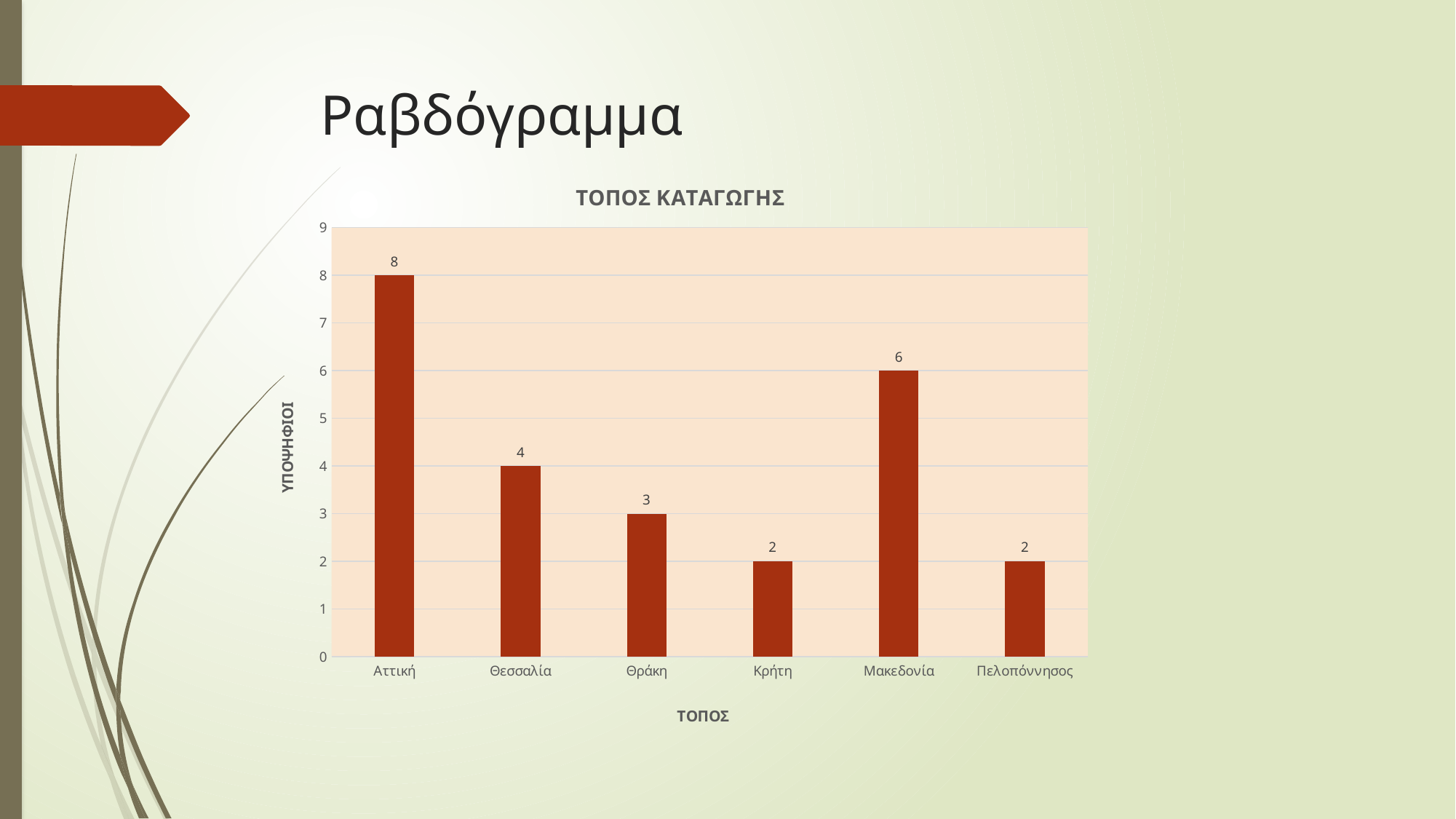
How many categories are shown on the x axis? 6 What is the value for Θράκη? 3 Which is larger, the value for Θεσσαλία or the value for Μακεδονία? Μακεδονία What kind of chart is shown on the slide? bar chart What is the difference between the values for Μακεδονία and Κρήτη? 4 What is the label of the vertical axis? ΥΠΟΨΗΦΙΟΙ Which category has the highest value? Αττική Is the value for Αττική greater or less than 5? greater What is the value for Αττική? 8 What is the difference between the values for Αττική and Θεσσαλία? 4 What is the value for Μακεδονία? 6 What is the title of the chart? ΤΟΠΟΣ ΚΑΤΑΓΩΓΗΣ